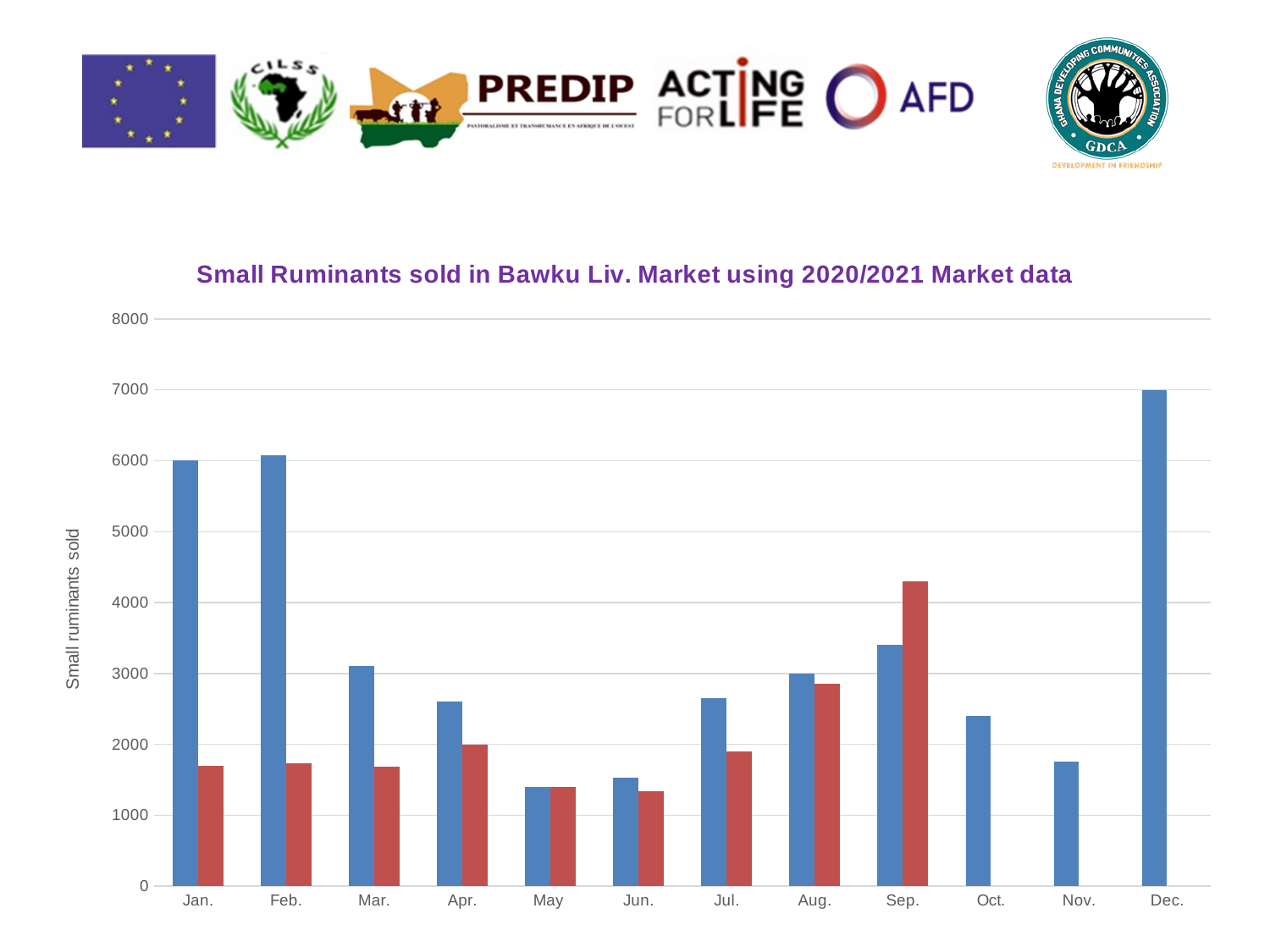
Is the blue bar for Dec. greater or less than 6000? greater In which month is the red bar the highest? Sep. In Jan., which bar is larger, the blue one or the red one? the blue one How many months are shown along the x axis of the chart? 12 Is the blue bar for Apr. greater or less than 3000? less Is the red bar for Sep. greater or less than 4000? greater In Sep., which bar is larger, the blue one or the red one? the red one What kind of chart is shown on the slide? bar chart In which month is the blue bar the highest? Dec. What is the label on the y axis of the chart? Small ruminants sold How many months have a red bar plotted? 9